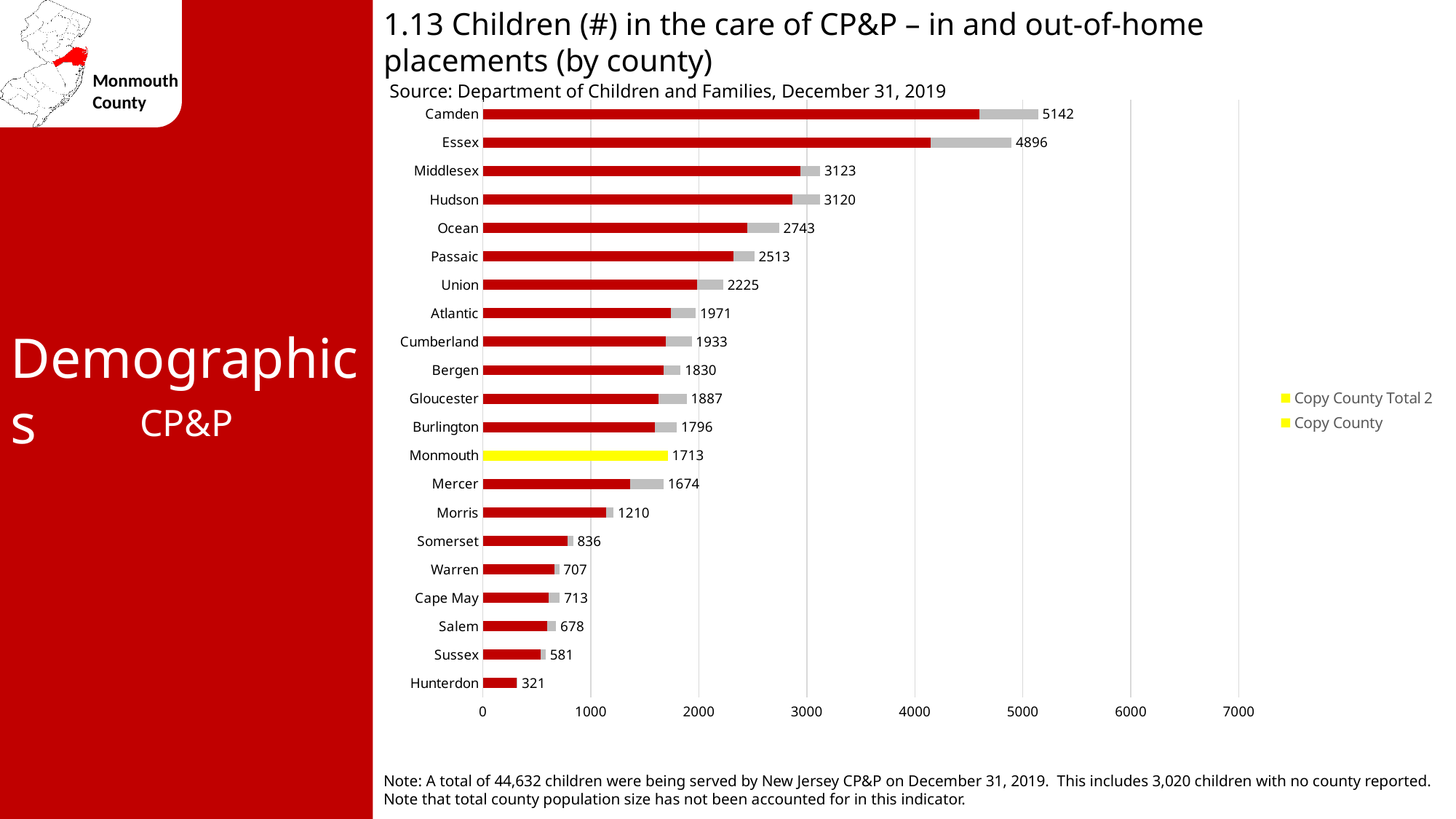
Which county has the lowest total number of children in the care of CP&P? Hunterdon What kind of chart is shown on the slide? Bar chart How many entries does the legend list? 2 Is the total for Middlesex greater or less than 3000? greater What is the total number of children in the care of CP&P for Monmouth? 1713 What is the total number of children in the care of CP&P for Hunterdon? 321 Which county has the highest total number of children in the care of CP&P? Camden Which county has a larger total, Ocean or Passaic? Ocean How many counties are shown in the chart? 21 What is the total number of children in the care of CP&P for Camden? 5142 What is the difference between the totals for Monmouth and Mercer? 39 What is the difference between the totals for Camden and Essex? 246